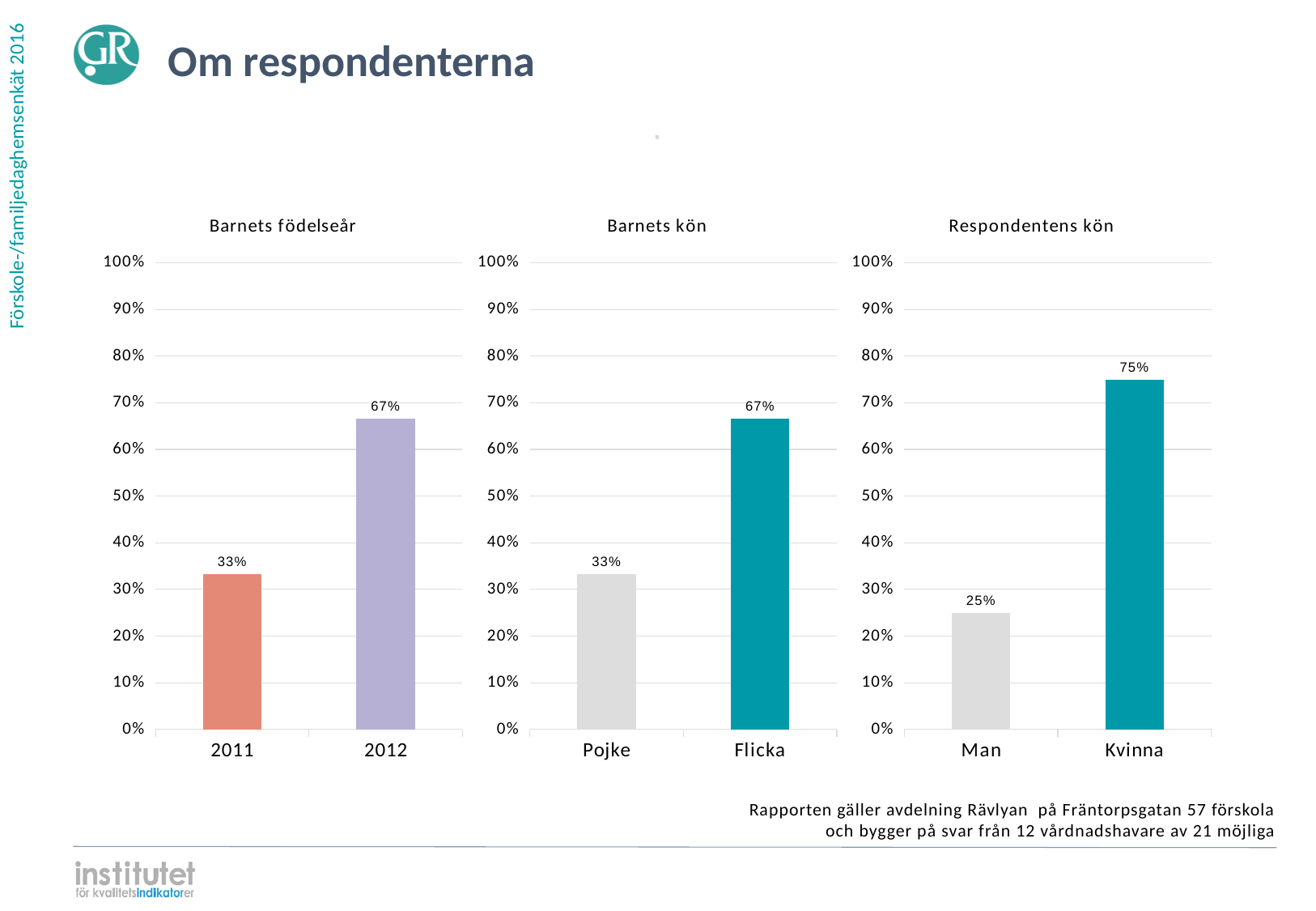
In the 'Barnets kön' chart, which category has the lowest value? Pojke In the 'Respondentens kön' chart, what is the value for Man? 25% In the 'Respondentens kön' chart, what is the difference between the values for Kvinna and Man? 50% In the 'Barnets födelseår' chart, what is the value for 2012? 67% In the 'Barnets födelseår' chart, what is the difference between the values for 2012 and 2011? 34% In the 'Respondentens kön' chart, which category has the highest value? Kvinna In the 'Respondentens kön' chart, is the value for Kvinna greater or less than 70%? greater What kind of chart is the 'Respondentens kön' chart? Bar chart In the 'Barnets födelseår' chart, what is the value for 2011? 33% In the 'Barnets kön' chart, which is larger, the value for Pojke or the value for Flicka? Flicka How many categories are shown in the 'Barnets kön' chart? 2 In the 'Barnets kön' chart, what is the value for Flicka? 67%